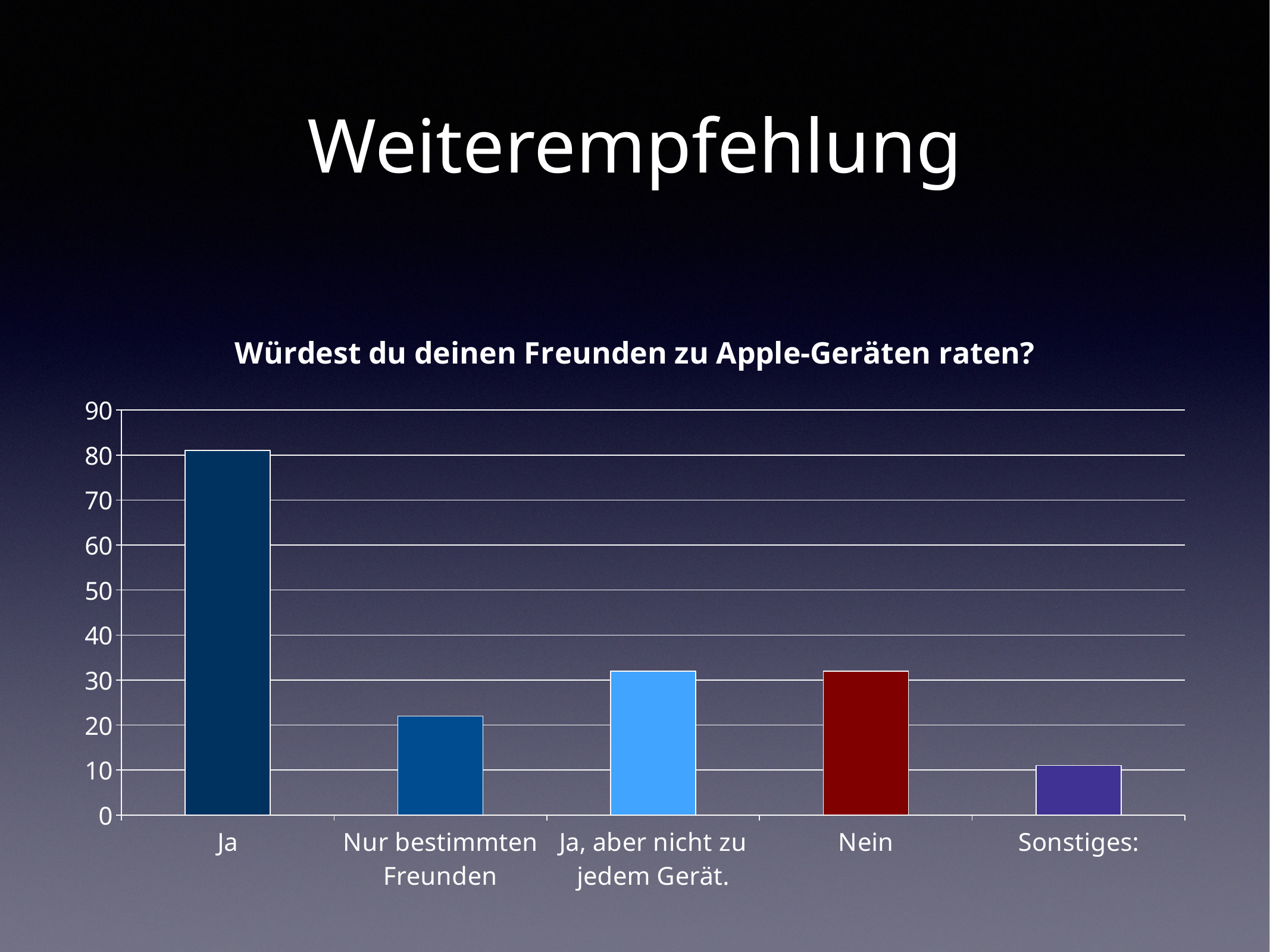
Is the value for Sonstiges: greater or less than 20? less Which category has the highest value? Ja Which is larger, the value for Ja or the value for Nein? Ja What is the title of the chart? Würdest du deinen Freunden zu Apple-Geräten raten? Which is larger, the value for Nur bestimmten Freunden or the value for Sonstiges:? Nur bestimmten Freunden How many categories are shown on the x axis of the chart? 5 Is the value for Nur bestimmten Freunden greater or less than 20? greater Is the value for Ja, aber nicht zu jedem Gerät. greater or less than 40? less What kind of chart is shown on the slide? bar chart Which category has the lowest value? Sonstiges: